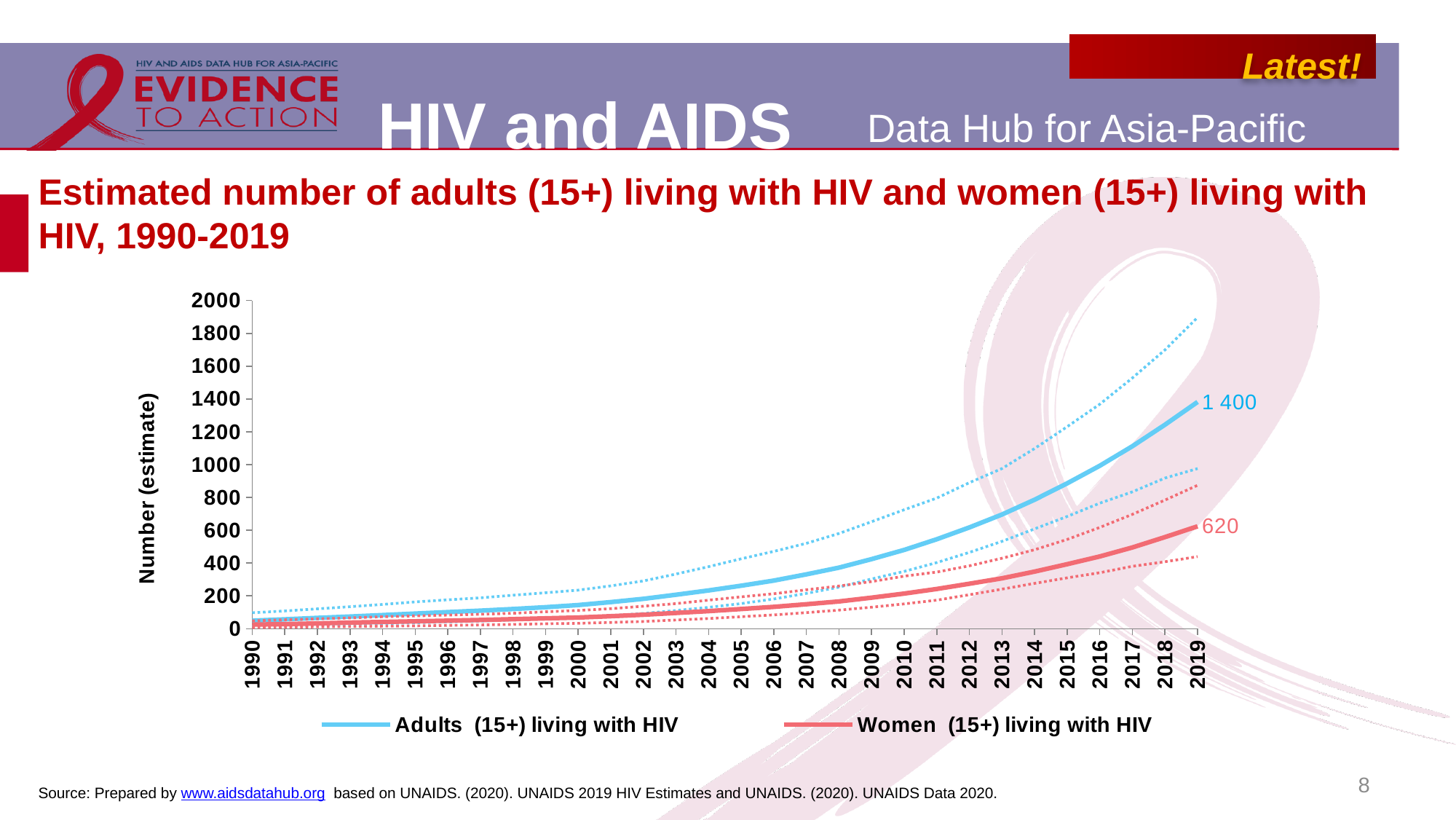
Is the value for adults (15+) living with HIV in 2010 greater or less than 600? less In 2019, which series has the larger value: adults (15+) living with HIV or women (15+) living with HIV? Adults (15+) living with HIV What is the difference between the 2019 values for adults (15+) living with HIV and women (15+) living with HIV? 780 Do the values for adults (15+) living with HIV rise or fall from 1990 to 2019? Rise What is the estimated number of women (15+) living with HIV in 2019? 620 How many series does the legend list? 2 What is the label of the y axis? Number (estimate) How many years are shown on the x axis of the chart? 30 What kind of chart is shown on the slide? Line chart Is the value for women (15+) living with HIV in 2000 greater or less than 200? less Is the value for adults (15+) living with HIV in 2016 greater or less than 800? greater What is the estimated number of adults (15+) living with HIV in 2019? 1 400